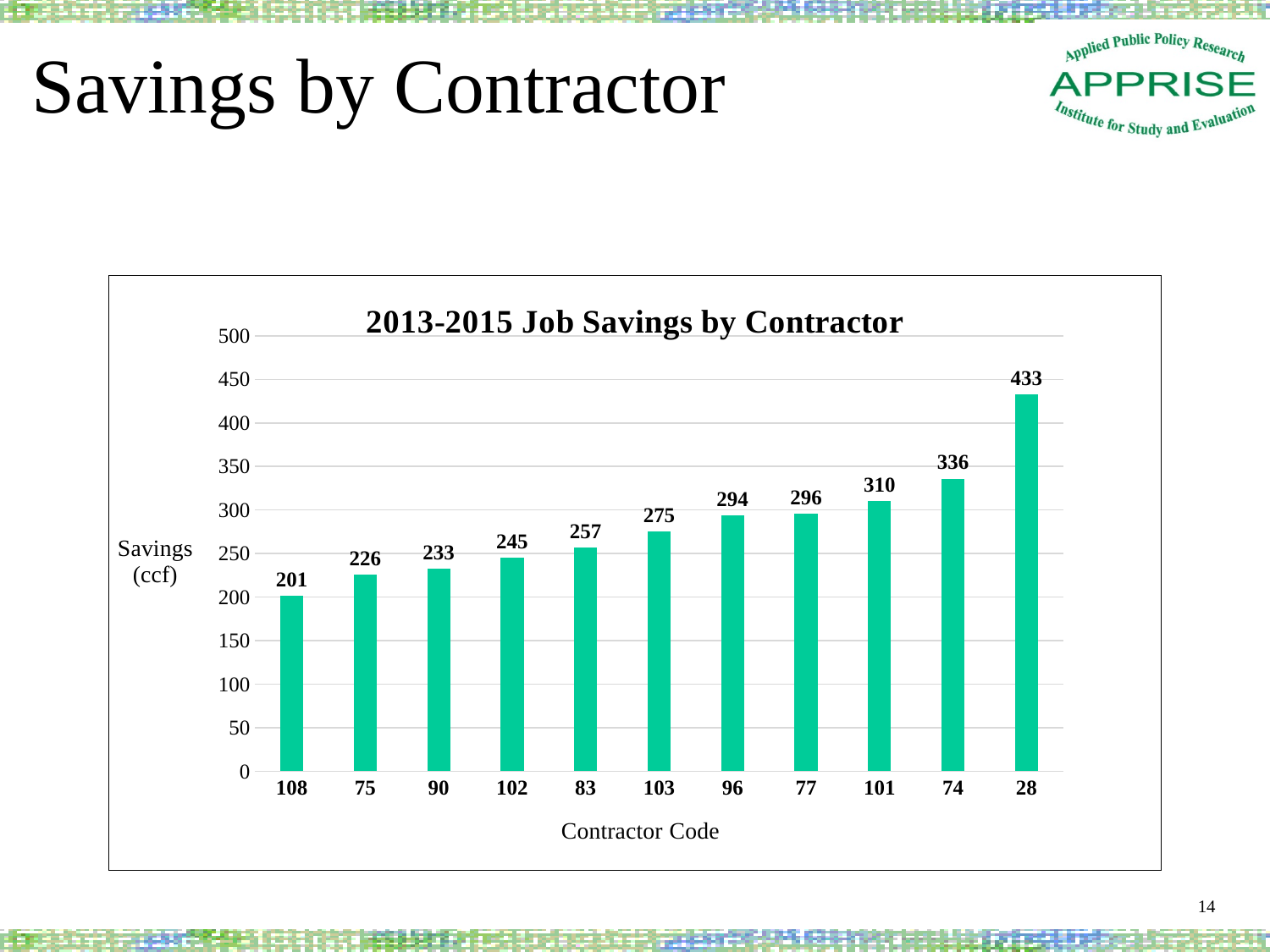
Do the savings values rise or fall from left to right along the x axis? rise What is the label of the y axis? Savings (ccf) What is the difference in savings between contractor code 28 and contractor code 74? 97 What is the savings value for contractor code 102? 245 Which has higher savings, contractor code 83 or contractor code 103? 103 What kind of chart is shown on the slide? bar chart Which contractor code has the highest savings? 28 Is the savings value for contractor code 101 greater or less than 300? greater What is the title of the chart? 2013-2015 Job Savings by Contractor Which contractor code has the lowest savings? 108 What is the savings value for contractor code 74? 336 How many contractor codes are shown in the chart? 11